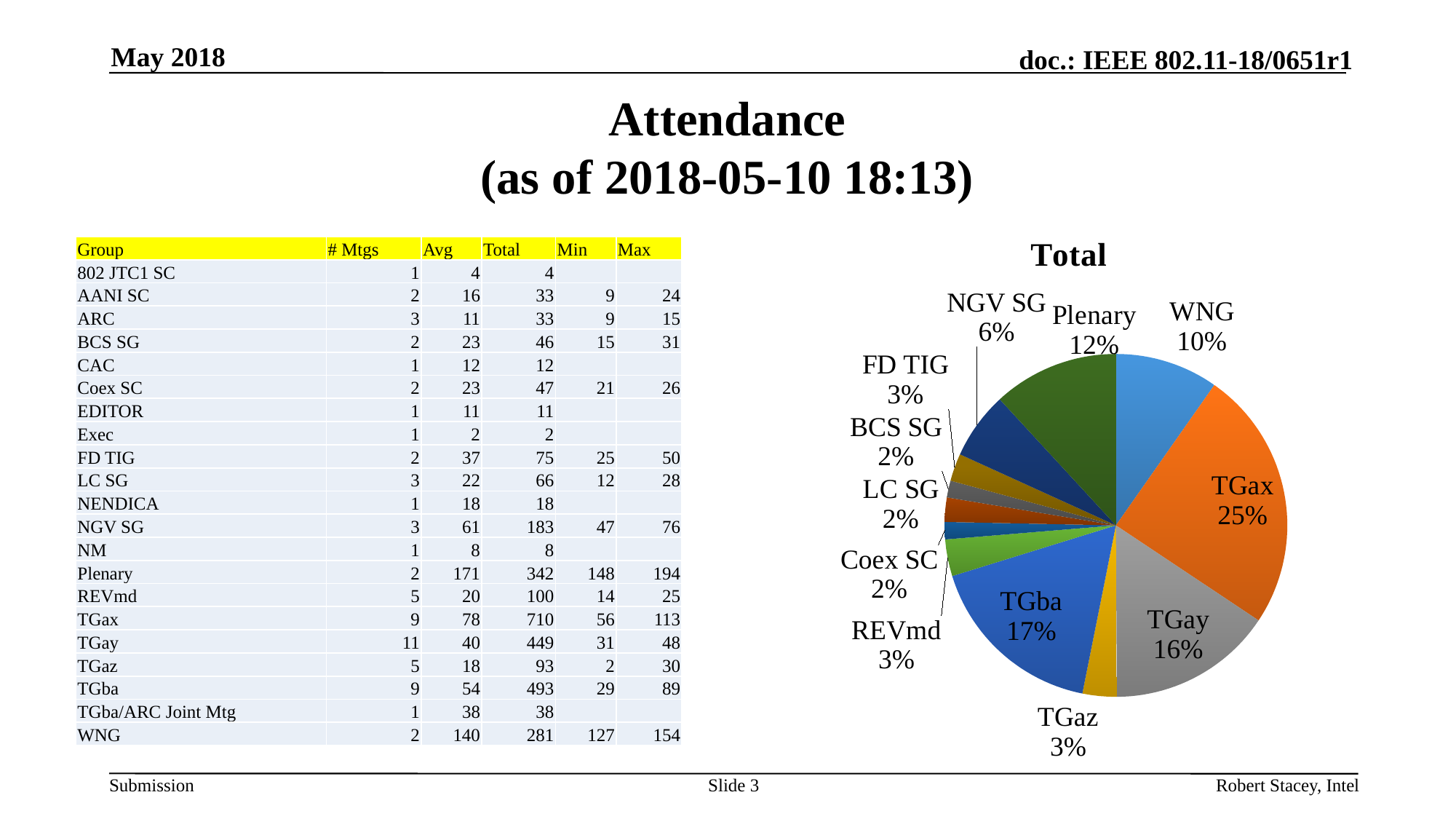
What share of the pie does Plenary have? 12% Which has the larger share of the pie, Plenary or WNG? Plenary What share of the pie does TGax have? 25% Which group has the largest slice of the pie? TGax What is the title of the pie chart? Total What share of the pie does TGaz have? 3% What kind of chart is shown on the slide? pie chart By how many percentage points does TGax's share exceed TGay's share? 9 Which has the larger share of the pie, TGay or TGba? TGba